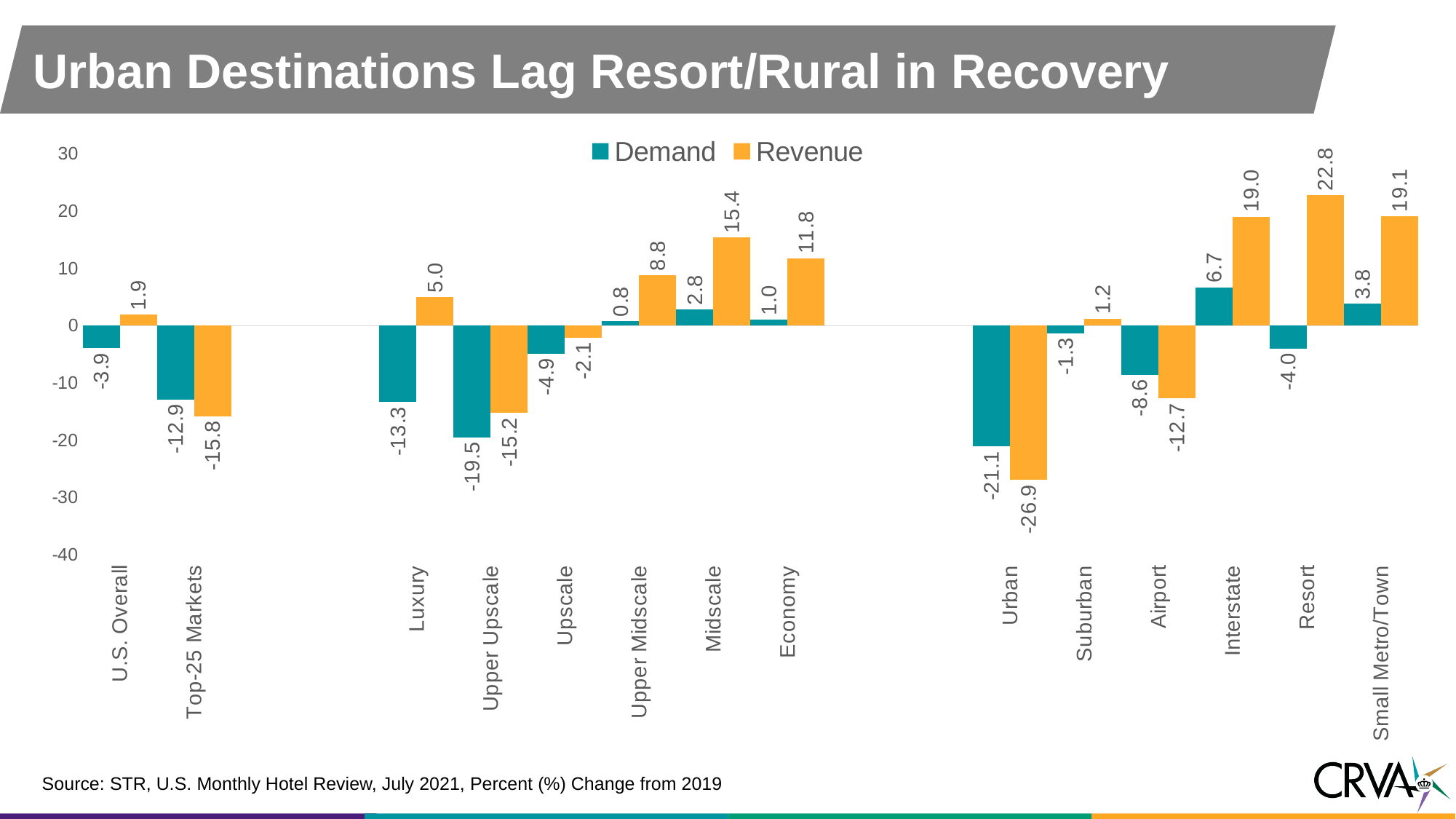
What is the Demand value for Urban? -21.1 What is the difference between the Revenue and Demand values for Resort? 26.8 What is the Revenue value for Resort? 22.8 Which category has the lowest Revenue value? Urban What is the Revenue value for U.S. Overall? 1.9 How many categories are shown on the x axis? 14 Which category has the highest Revenue value? Resort How many series does the legend list? 2 Which series is shown in orange? Revenue Which category has the highest Demand value? Interstate Which is larger, the Revenue value for Interstate or the Revenue value for Small Metro/Town? Small Metro/Town What kind of chart is shown on the slide? Bar chart